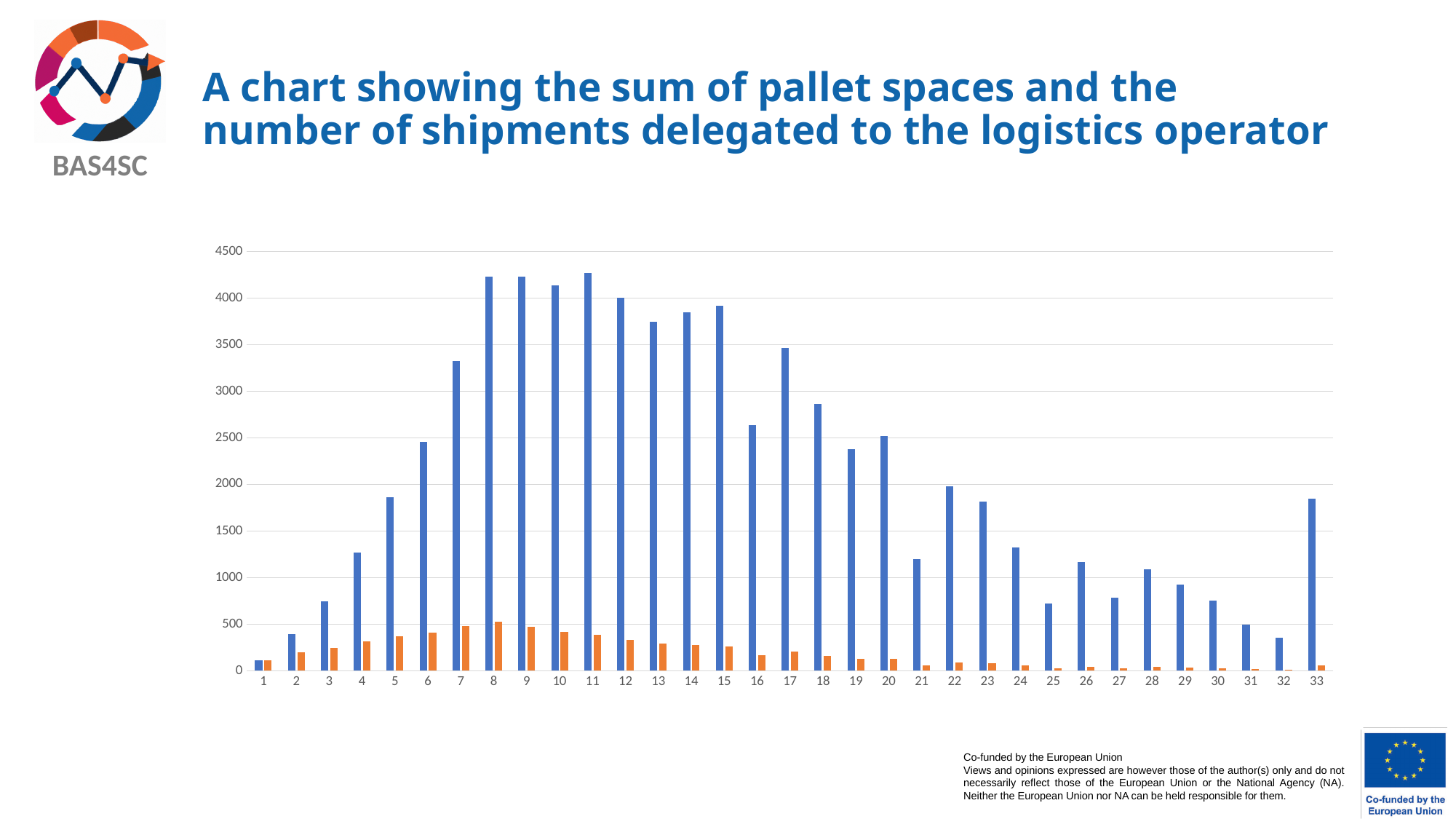
What kind of chart is shown on the slide? Bar chart Which category has the lowest blue bar? 1 How many data series are plotted in the chart? 2 Is the blue bar for category 7 greater or less than 3000? greater What is the title of the chart on the slide? A chart showing the sum of pallet spaces and the number of shipments delegated to the logistics operator Is the blue bar for category 1 greater or less than 500? less Is the blue bar for category 18 greater or less than 3000? less Which is larger, the blue bar for category 7 or the blue bar for category 18? Category 7 How many categories are shown along the x axis of the chart? 33 Do the blue bars rise or fall from category 1 to category 11? Rise